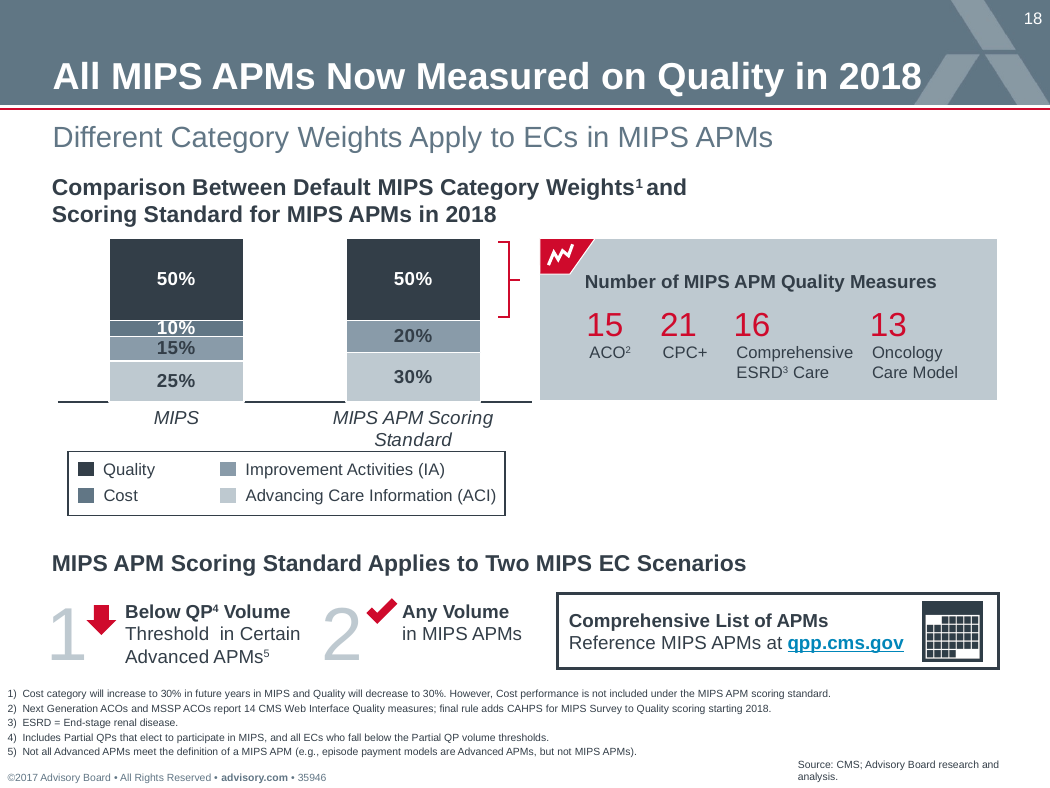
How many bars are shown in the stacked bar chart? 2 In the stacked bar chart, how much larger is the ACI weight in the MIPS APM Scoring Standard bar than in the MIPS bar? 5% In the stacked bar chart, what is the Improvement Activities (IA) weight for the MIPS APM Scoring Standard bar? 20% In the stacked bar chart, what is the Advancing Care Information (ACI) weight for the MIPS APM Scoring Standard bar? 30% In the stacked bar chart, what is the Improvement Activities (IA) weight for the MIPS bar? 15% What kind of chart is used to compare the MIPS category weights? Stacked bar chart In the stacked bar chart, which category has the smallest weight in the MIPS bar? Cost In the stacked bar chart, which bar has the larger Improvement Activities (IA) weight, MIPS or MIPS APM Scoring Standard? MIPS APM Scoring Standard How many entries does the legend of the stacked bar chart list? 4 In the stacked bar chart, what is the Cost weight shown for the MIPS bar? 10% In the stacked bar chart, what is the Quality weight shown for the MIPS bar? 50% In the stacked bar chart, what is the total of the segments in the MIPS bar? 100%